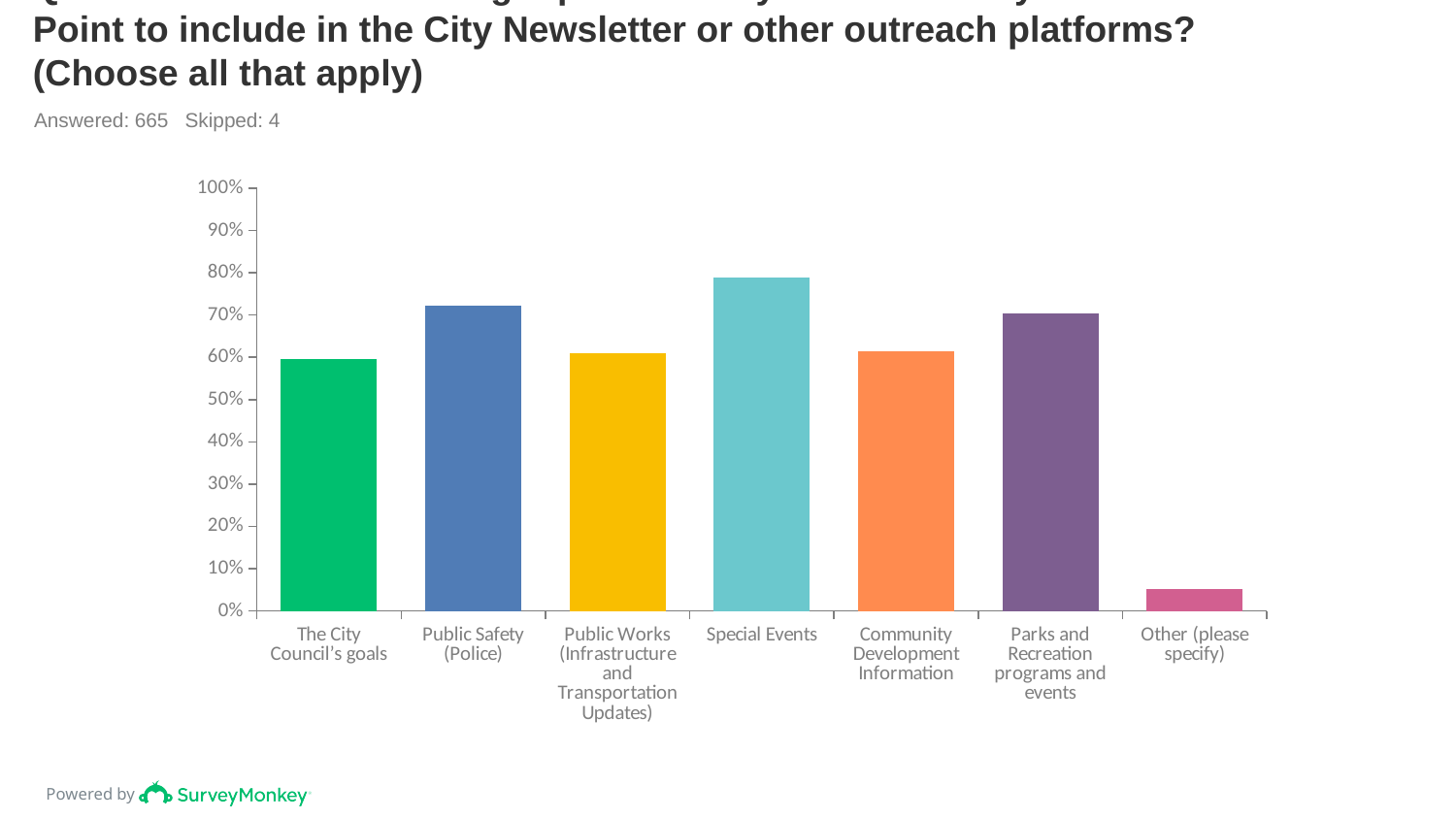
Which is larger, the value for Special Events or the value for Public Safety (Police)? Special Events Which category has the highest value in the chart? Special Events Is the value for Special Events greater or less than 70%? greater Is the value for Community Development Information greater or less than 50%? greater Is the value for The City Council's goals greater or less than 70%? less Which is larger, the value for Public Safety (Police) or the value for The City Council's goals? Public Safety (Police) How many categories are shown on the x axis of the chart? 7 What kind of chart is shown on the slide? bar chart Which category has the lowest value in the chart? Other (please specify)